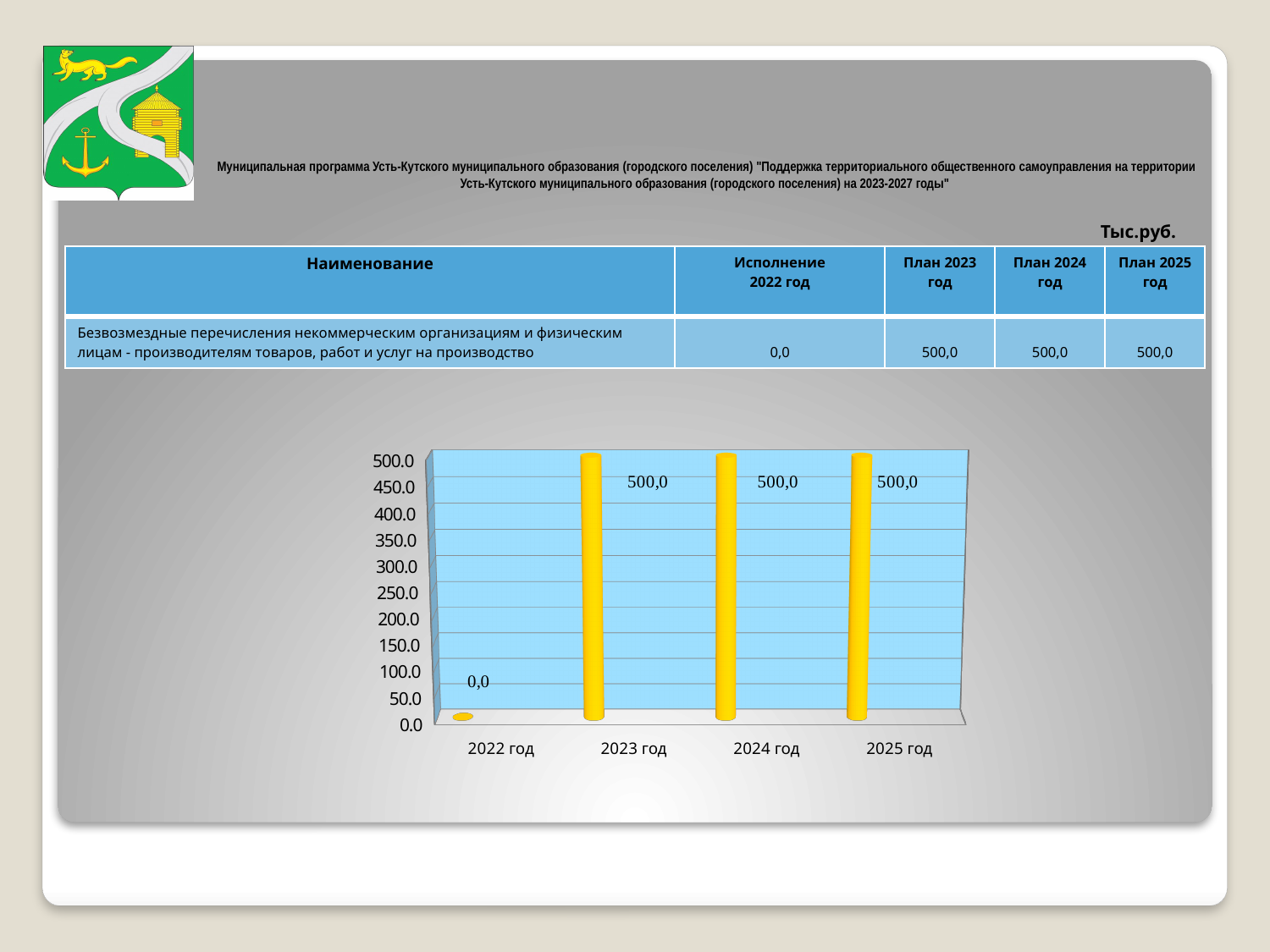
Which year has the lowest value on the chart? 2022 год What is the difference between the values for 2023 год and 2022 год? 500,0 What is the value shown for 2023 год on the chart? 500,0 Which is larger, the value for 2024 год or the value for 2022 год? 2024 год How many years are shown on the x axis of the chart? 4 What is the value shown for 2025 год on the chart? 500,0 What kind of chart is shown on the slide? bar chart Does the value rise or fall from 2022 год to 2023 год? rise What is the value shown for 2022 год on the chart? 0,0 What is the highest tick value on the vertical axis of the chart? 500.0 Is the value for 2024 год greater or less than 250.0? greater What colour are the bars in the chart? yellow